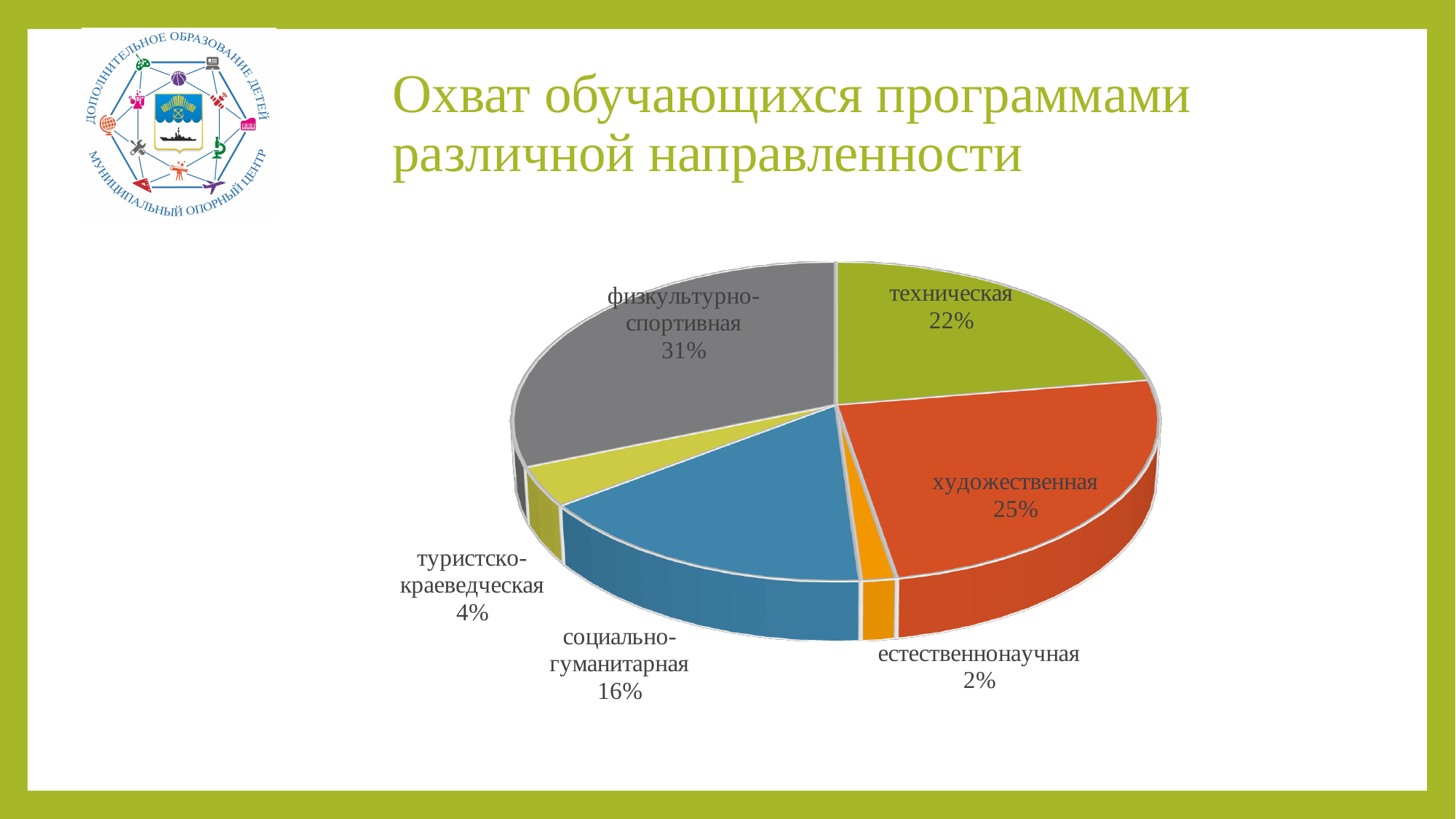
What is the difference in percentage points between the физкультурно-спортивная and художественная slices? 6 Which category has the largest share of the pie? физкультурно-спортивная What share of the pie does the художественная slice represent? 25% What kind of chart is shown on the slide? pie chart Which slice is larger, техническая or социально-гуманитарная? техническая What share of the pie does the естественнонаучная slice represent? 2% What share of the pie does the социально-гуманитарная slice represent? 16% Which category has the smallest share of the pie? естественнонаучная What is the title of the slide? Охват обучающихся программами различной направленности How many categories are shown in the pie chart? 6